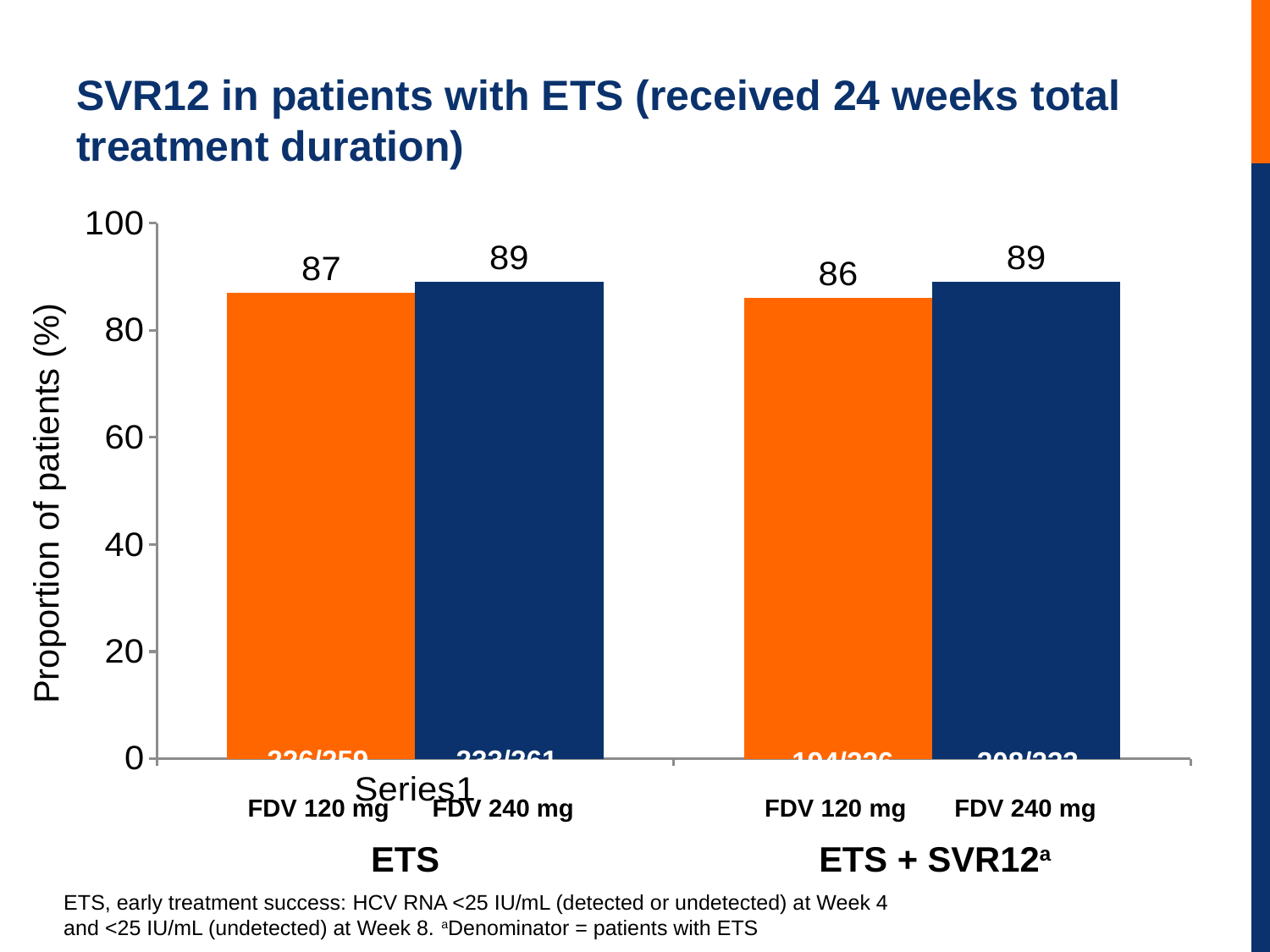
Is the value for FDV 120 mg in the ETS + SVR12 group greater or less than 80? greater What is the SVR12 value for FDV 120 mg in the ETS + SVR12 group? 86 Which bar has the lowest value on the chart? FDV 120 mg in ETS + SVR12 What type of chart is shown on the slide? Bar chart What is the difference between the FDV 240 mg and FDV 120 mg values in the ETS + SVR12 group? 3 What is the difference between the FDV 240 mg and FDV 120 mg values in the ETS group? 2 What is the label of the y-axis? Proportion of patients (%) What is the SVR12 value for FDV 240 mg in the ETS + SVR12 group? 89 In the ETS group, which dose has the higher value, FDV 120 mg or FDV 240 mg? FDV 240 mg What is the SVR12 value for FDV 240 mg in the ETS group? 89 What is the SVR12 value for FDV 120 mg in the ETS group? 87 How many bars are plotted on the chart? 4